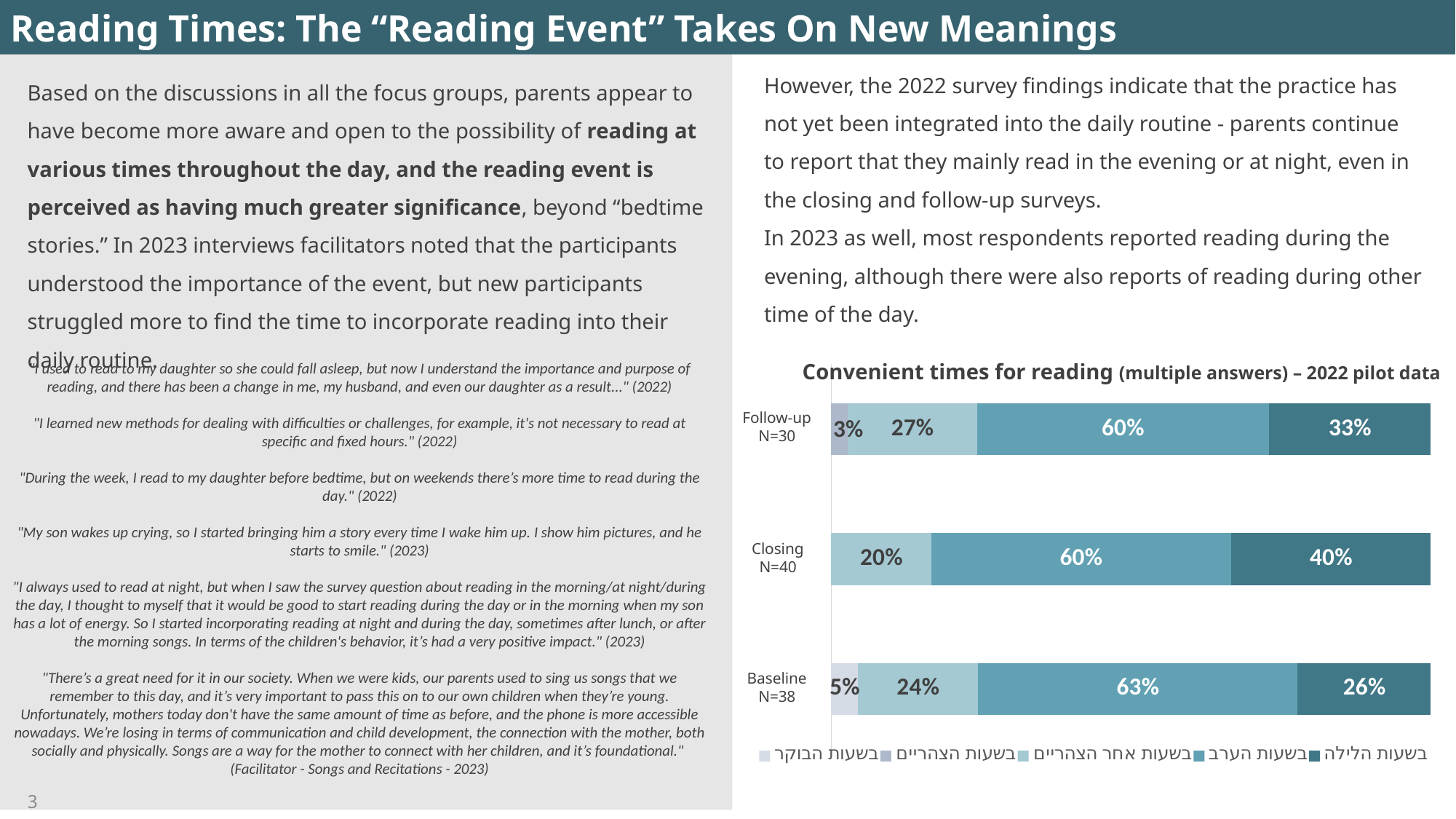
Which survey group has the highest value for the בשעות הלילה (night) segment? Closing N=40 How many series does the chart legend list? 5 What is the title of the chart on the slide? Convenient times for reading (multiple answers) – 2022 pilot data What is the difference between the בשעות הלילה (night) values for Closing N=40 and Baseline N=38? 14% What type of chart is shown on the slide? Stacked bar chart What is the value of the בשעות הערב (evening) segment for the Baseline N=38 bar? 63% Which survey group has the lowest value for the בשעות אחר הצהריים (afternoon) segment? Closing N=40 What is the value of the בשעות אחר הצהריים (afternoon) segment for the Follow-up N=30 bar? 27% What is the value of the בשעות הלילה (night) segment for the Closing N=40 bar? 40% What is the sample size shown for the Closing group? N=40 Is the בשעות הערב (evening) value larger for Baseline N=38 or for Follow-up N=30? Baseline N=38 How many survey groups (bars) are shown in the chart? 3